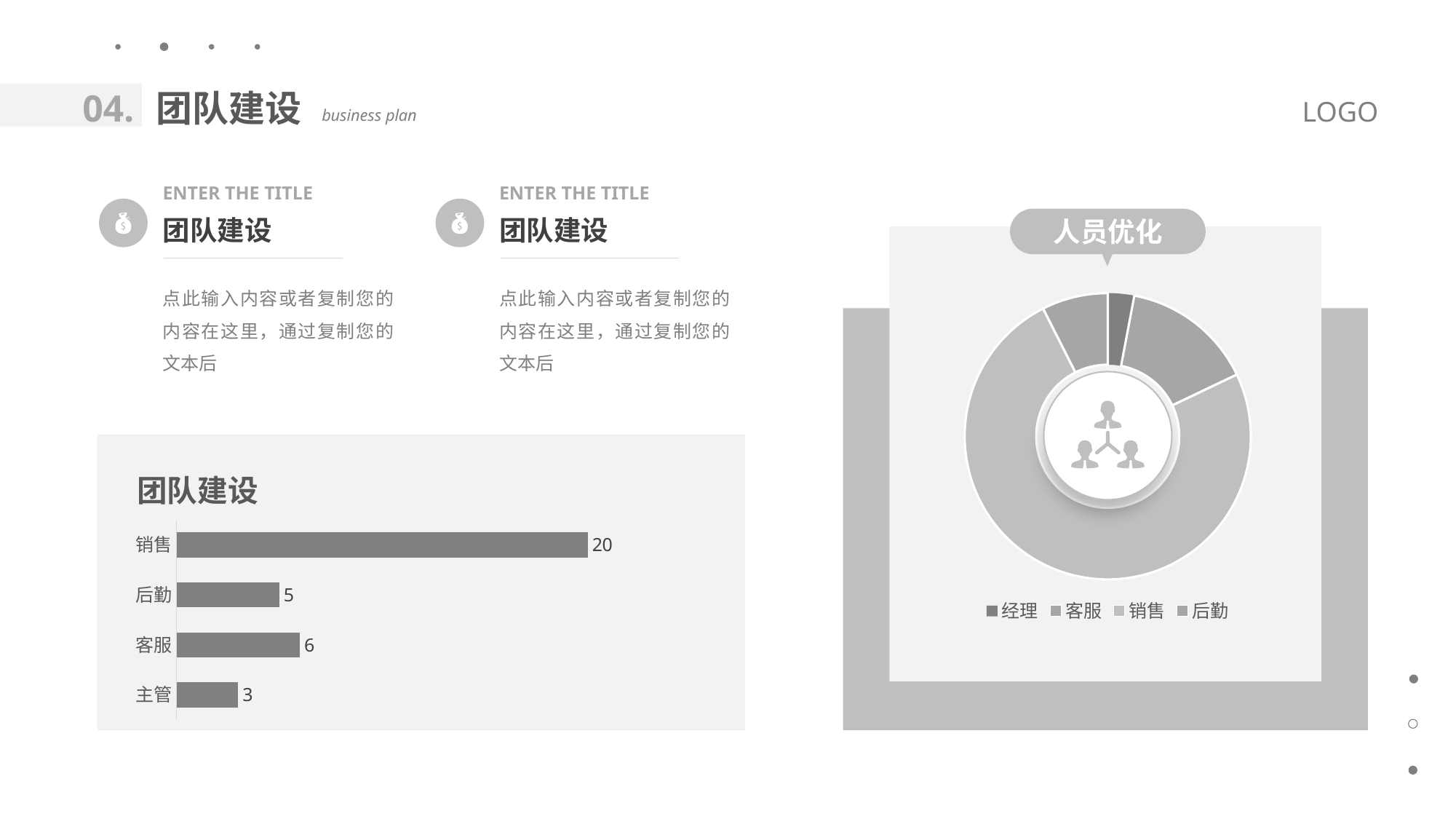
In the bar chart titled 团队建设, what is the difference between the values for 销售 and 客服? 14 In the bar chart titled 团队建设, what is the value for 后勤? 5 In the bar chart titled 团队建设, which category has the highest value? 销售 What kind of chart is the chart titled 团队建设 on the left of the slide? bar chart What kind of chart is the chart titled 人员优化 on the right of the slide? doughnut chart In the bar chart titled 团队建设, what is the value for 客服? 6 In the bar chart titled 团队建设, which is larger, the value for 后勤 or the value for 客服? 客服 How many entries does the legend of the chart titled 人员优化 list? 4 In the bar chart titled 团队建设, which category has the lowest value? 主管 In the bar chart titled 团队建设, what is the value for 主管? 3 In the bar chart titled 团队建设, what is the value for 销售? 20 How many categories are shown in the bar chart titled 团队建设? 4